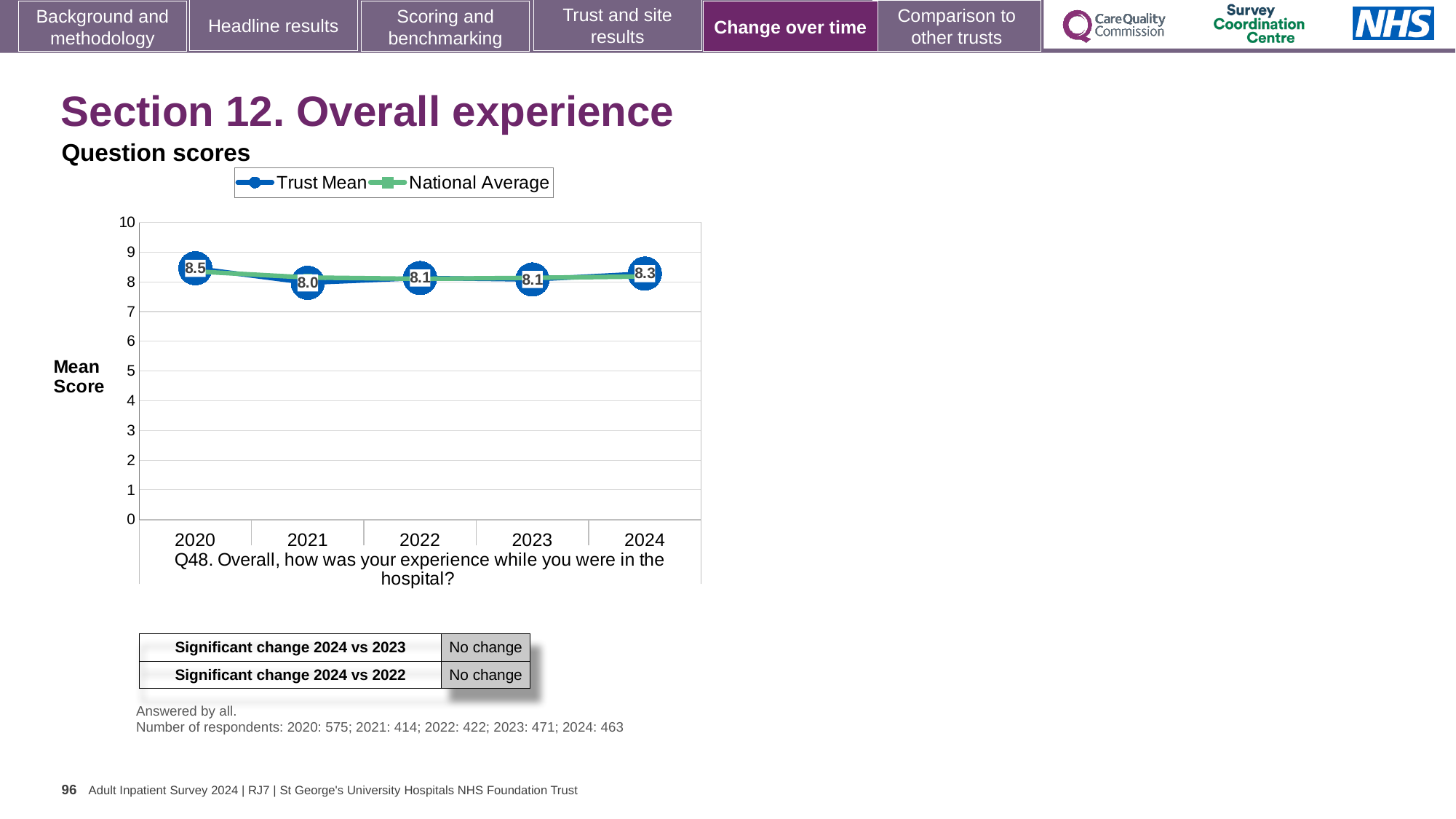
What is the Trust Mean score for 2021? 8.0 Is the Trust Mean higher in 2024 or in 2023? 2024 What is the Trust Mean score for 2024? 8.3 How many series does the legend list? 2 What kind of chart is shown? Line chart In which year is the Trust Mean highest? 2020 What is the Trust Mean score for 2020? 8.5 What is the difference between the Trust Mean in 2020 and in 2021? 0.5 Does the Trust Mean rise or fall from 2020 to 2021? Fall Is the National Average value for 2022 greater or less than 5? greater How many years are plotted on the x axis? 5 In which year is the Trust Mean lowest? 2021